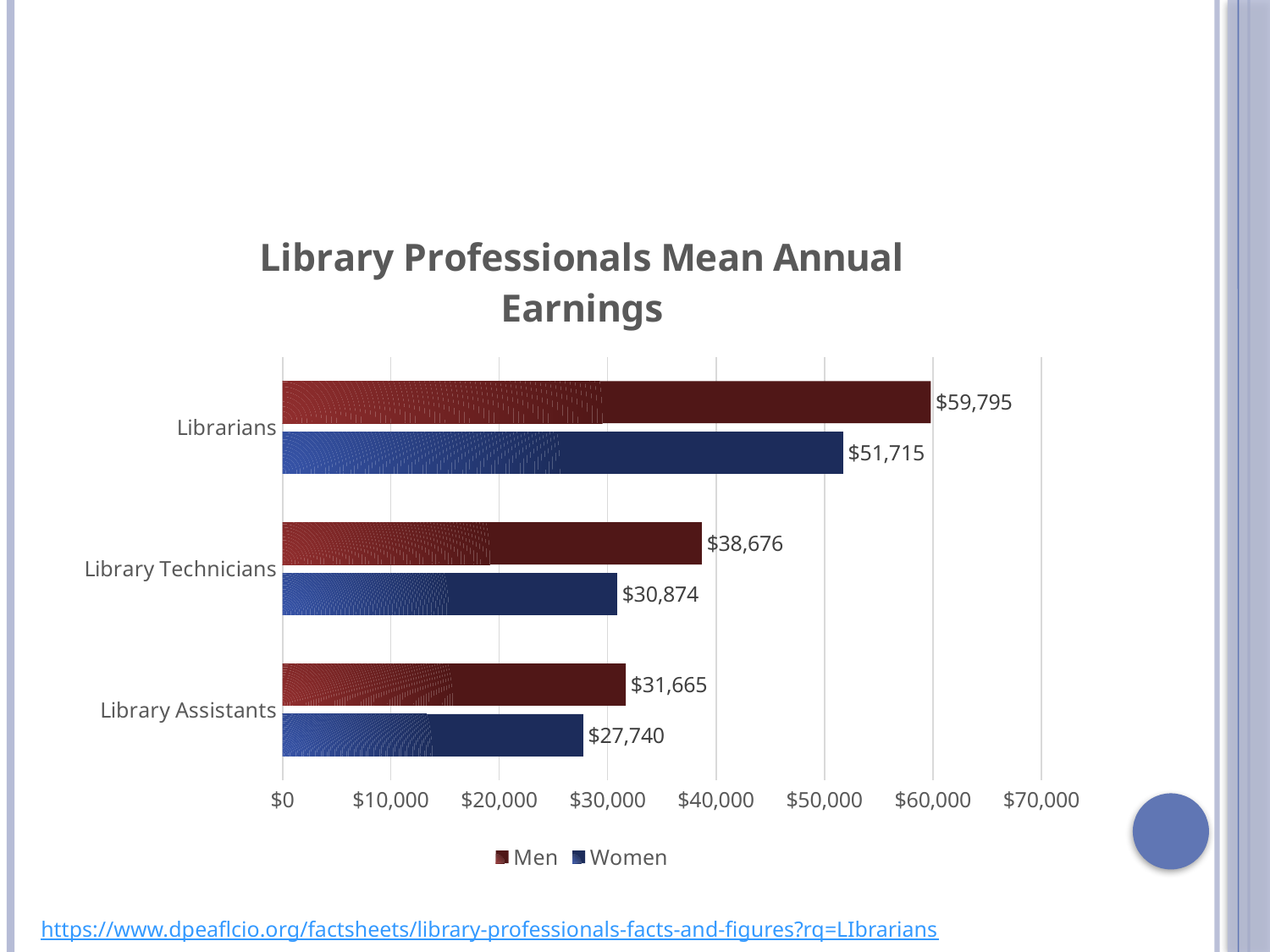
How many series does the legend list? 2 What is the mean annual earnings for Women among Library Technicians? $30,874 How many job categories are shown on the chart? 3 What is the mean annual earnings for Men among Librarians? $59,795 What kind of chart is shown on the slide? Bar chart What is the difference between Men's and Women's mean annual earnings for Library Technicians? $7,802 Which category has the highest value for Men? Librarians Which is larger: Men's earnings for Library Assistants or Women's earnings for Library Technicians? Men's earnings for Library Assistants Which category has the lowest value for Women? Library Assistants Is the value for Women among Librarians greater or less than $50,000? greater What is the difference between Men's and Women's mean annual earnings for Librarians? $8,080 What is the mean annual earnings for Women among Library Assistants? $27,740